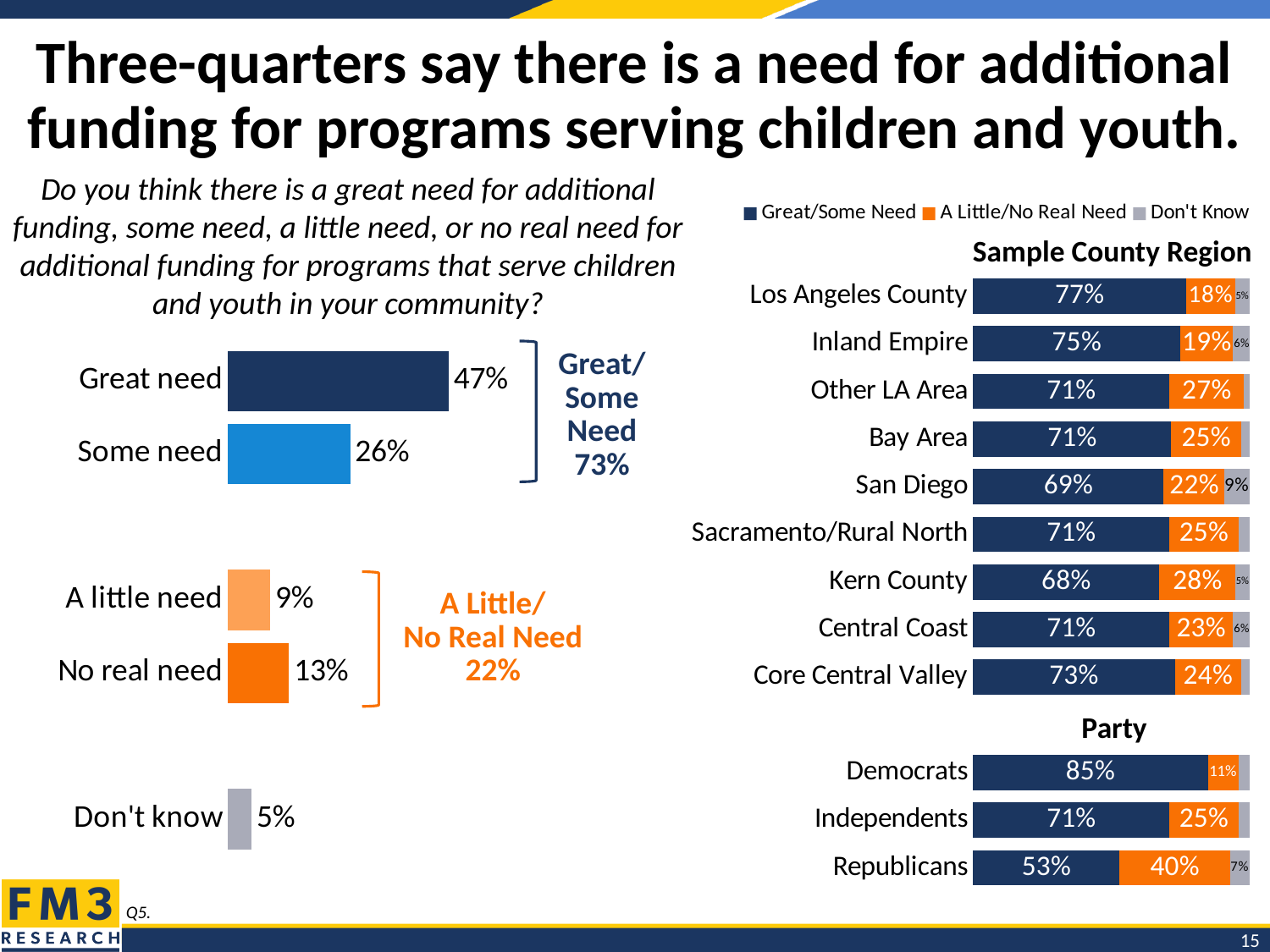
On the right chart, what is the Great/Some Need percentage for Los Angeles County? 77% On the right chart, how many series does the legend list? 3 On the right chart, which party has the lowest Great/Some Need percentage? Republicans On the left chart, what combined percentage is shown for 'Great/Some Need'? 73% On the left chart, how many response categories are shown? 5 On the right chart, what is the difference in Great/Some Need percentage points between Democrats and Republicans? 32 percentage points On the left chart, what percentage of respondents said there is a great need for additional funding? 47% What type of chart is the left chart? Bar chart On the left chart, which response category has the highest percentage? Great need On the right chart, which region has the highest Great/Some Need percentage? Los Angeles County On the left chart, what is the difference in percentage points between 'Great need' and 'Some need'? 21 percentage points On the left chart, which response category has the lowest percentage? Don't know